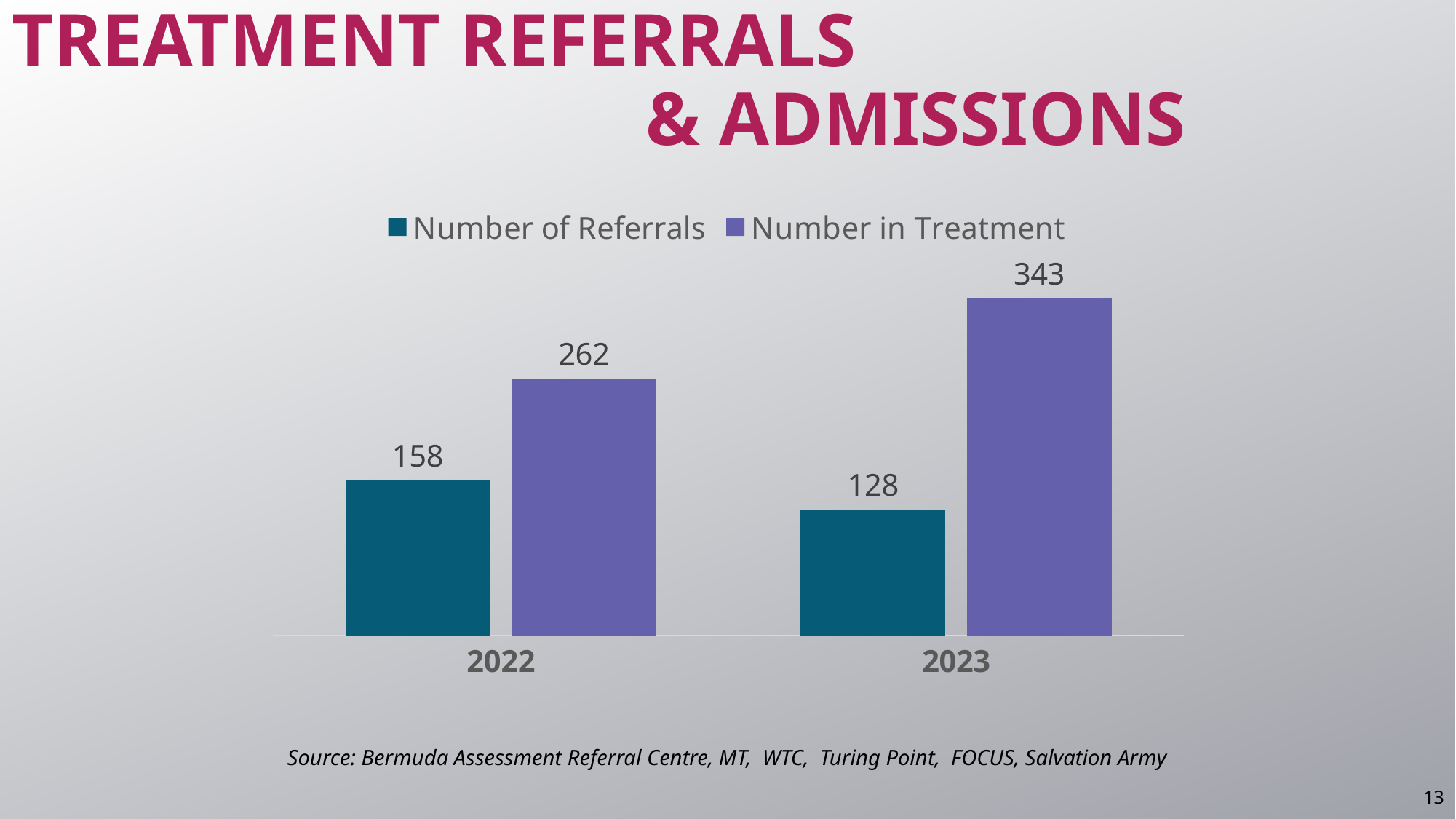
What is the Number of Referrals for 2023? 128 What is the difference between the Number in Treatment in 2023 and in 2022? 81 How many series does the legend list? 2 Which year has the higher Number in Treatment? 2023 What is the Number of Referrals for 2022? 158 What is the Number in Treatment for 2023? 343 Which year has the lower Number of Referrals? 2023 What is the difference between the Number of Referrals in 2022 and in 2023? 30 What is the Number in Treatment for 2022? 262 How many years are shown on the x axis? 2 Which is larger in 2022: the Number of Referrals or the Number in Treatment? Number in Treatment What kind of chart is shown on the slide? Bar chart